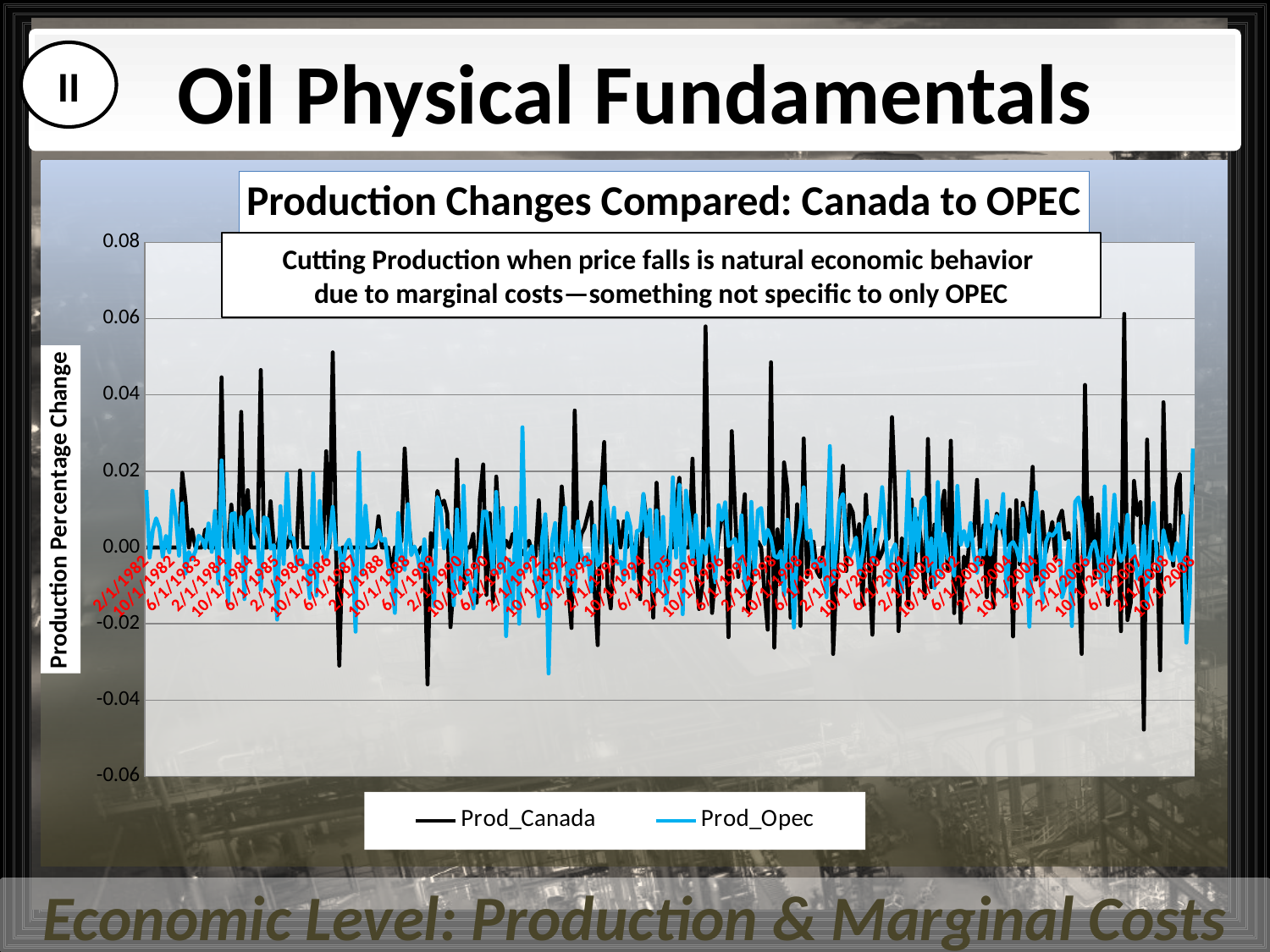
Which series is drawn in black, Prod_Canada or Prod_Opec? Prod_Canada Is the highest value reached by the Prod_Canada series greater or less than 0.04? greater Is the lowest value reached by the Prod_Opec series greater or less than -0.04? greater Is the lowest value reached by the Prod_Canada series greater or less than -0.04? less What is the label on the vertical axis of the chart? Production Percentage Change What is the title of the chart? Production Changes Compared: Canada to OPEC What is the first date label shown on the horizontal axis? 2/1/1982 What kind of chart is shown on the slide? Line chart How many series does the legend list? 2 Which series reaches a higher peak value, Prod_Canada or Prod_Opec? Prod_Canada